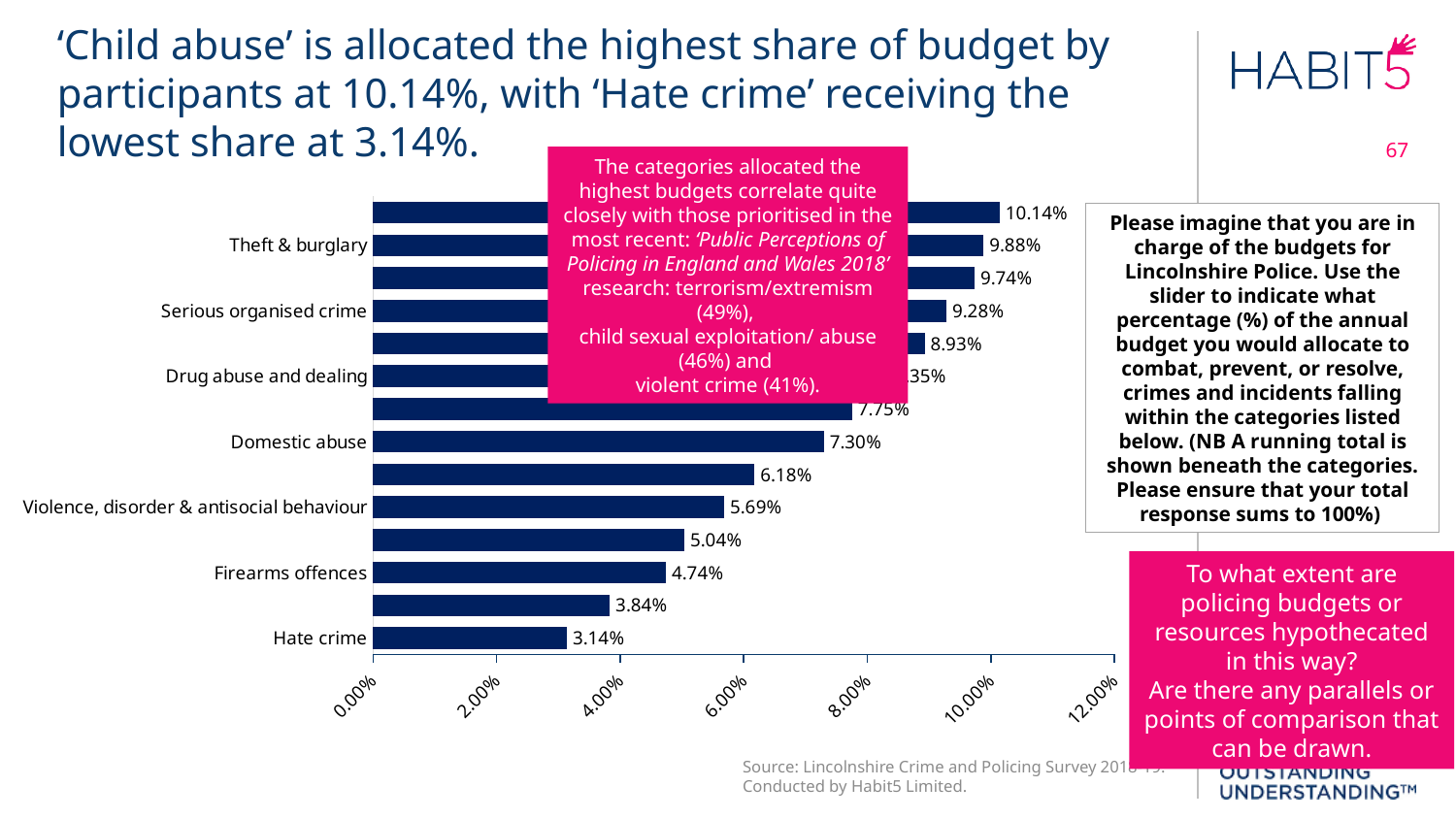
Is the value for Firearms offences greater or less than 6.00%? less What percentage is allocated to Domestic abuse? 7.30% What kind of chart is shown on the slide? Bar chart Which category receives the lowest share of the budget? Hate crime Which has a larger value, Domestic abuse or Firearms offences? Domestic abuse What percentage is allocated to Firearms offences? 4.74% What is the difference between the values for Theft & burglary and Hate crime? 6.74% What value is shown for Serious organised crime? 9.28% What value is shown for Violence, disorder & antisocial behaviour? 5.69% How many bars are plotted on the chart? 14 What is the highest value shown on the chart? 10.14% What percentage of the budget is allocated to Theft & burglary? 9.88%